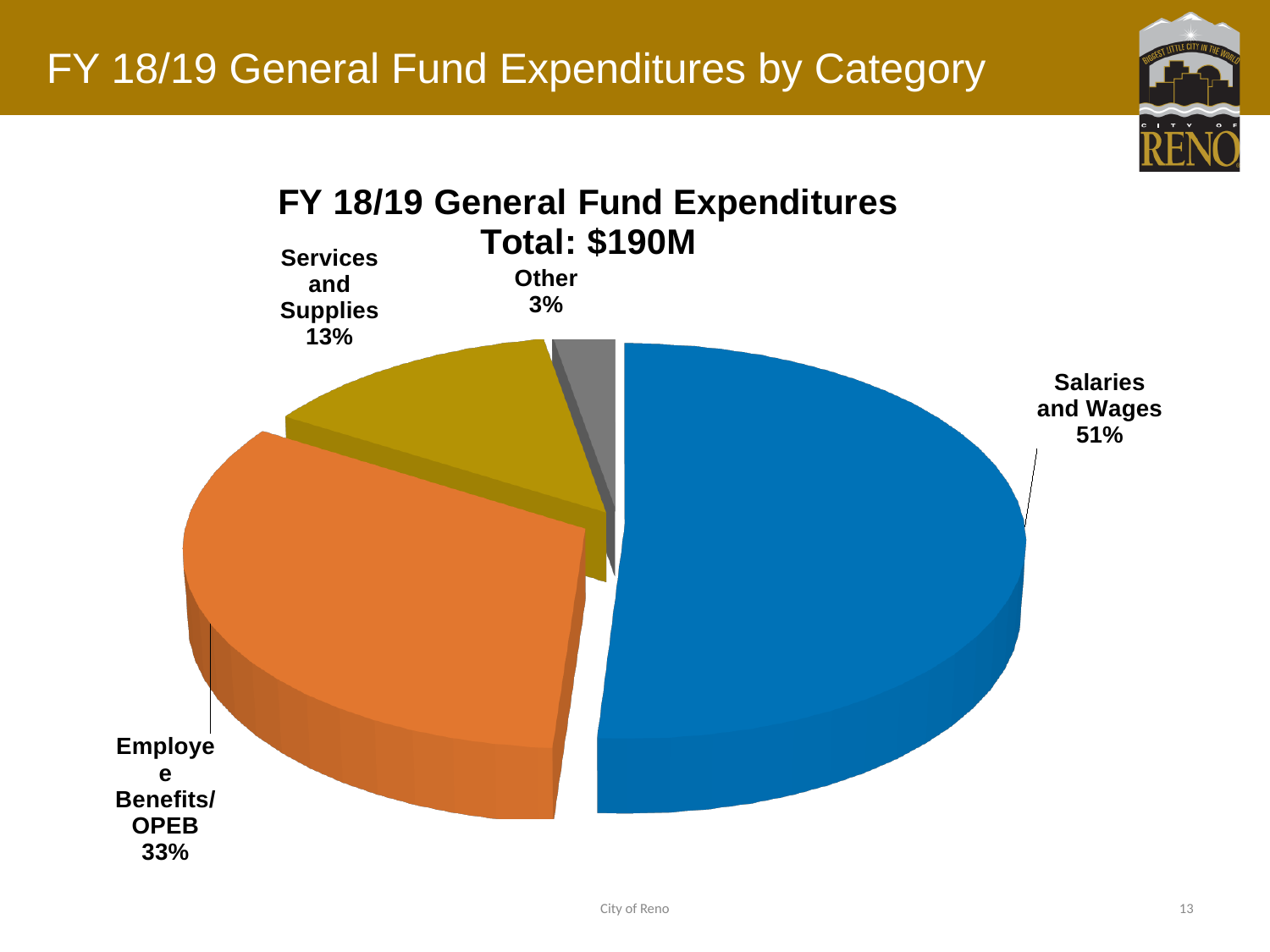
What type of chart is shown on the slide? Pie chart What is the difference in percentage points between Salaries and Wages and Employee Benefits/OPEB? 18 What share of FY 18/19 General Fund Expenditures is Salaries and Wages? 51% What total amount is stated in the chart title? $190M What percentage is shown for the Other category? 3% What colour is the Salaries and Wages slice? Blue What percentage is shown for Services and Supplies? 13% What share of the pie is Employee Benefits/OPEB? 33% Which is larger: Services and Supplies or Other? Services and Supplies Which category has the smallest share of expenditures? Other How many categories are shown in the pie chart? 4 Which category has the largest share of expenditures? Salaries and Wages